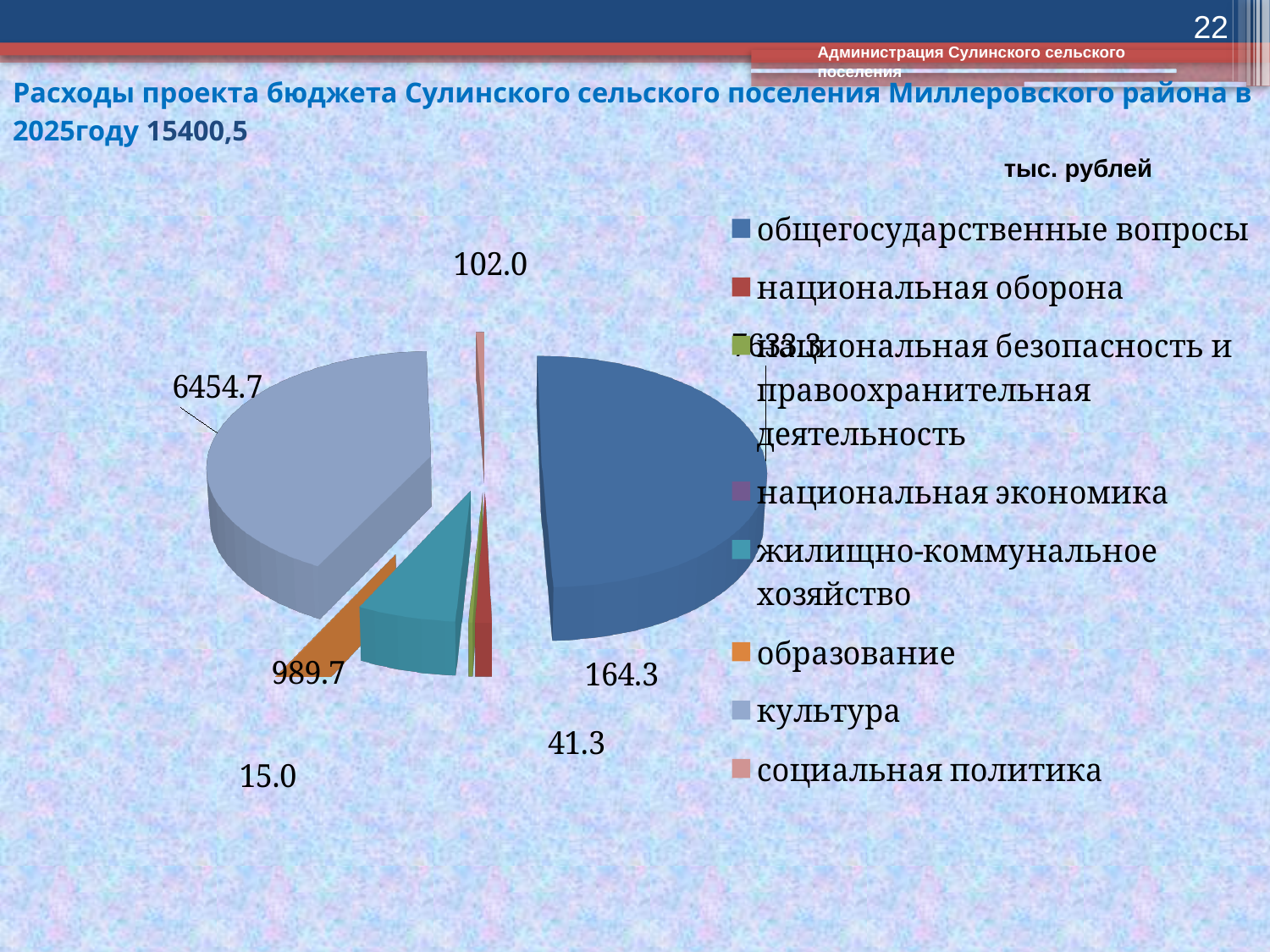
Which is larger, the value for культура or the value for социальная политика? культура What is the value shown for культура? 6454.7 How many categories does the legend of the pie chart list? 8 What is the difference between the value for культура and the value for социальная политика? 6352.7 What total expenditure figure is given in the slide title? 15400,5 Which category has the largest slice of the pie? общегосударственные вопросы Which is larger, the slice for общегосударственные вопросы or the slice for культура? общегосударственные вопросы What is the smallest data label printed on the pie chart? 15.0 What is the value shown for социальная политика? 102.0 What kind of chart is shown on the slide? pie chart In what units are the values on the chart expressed? тыс. рублей